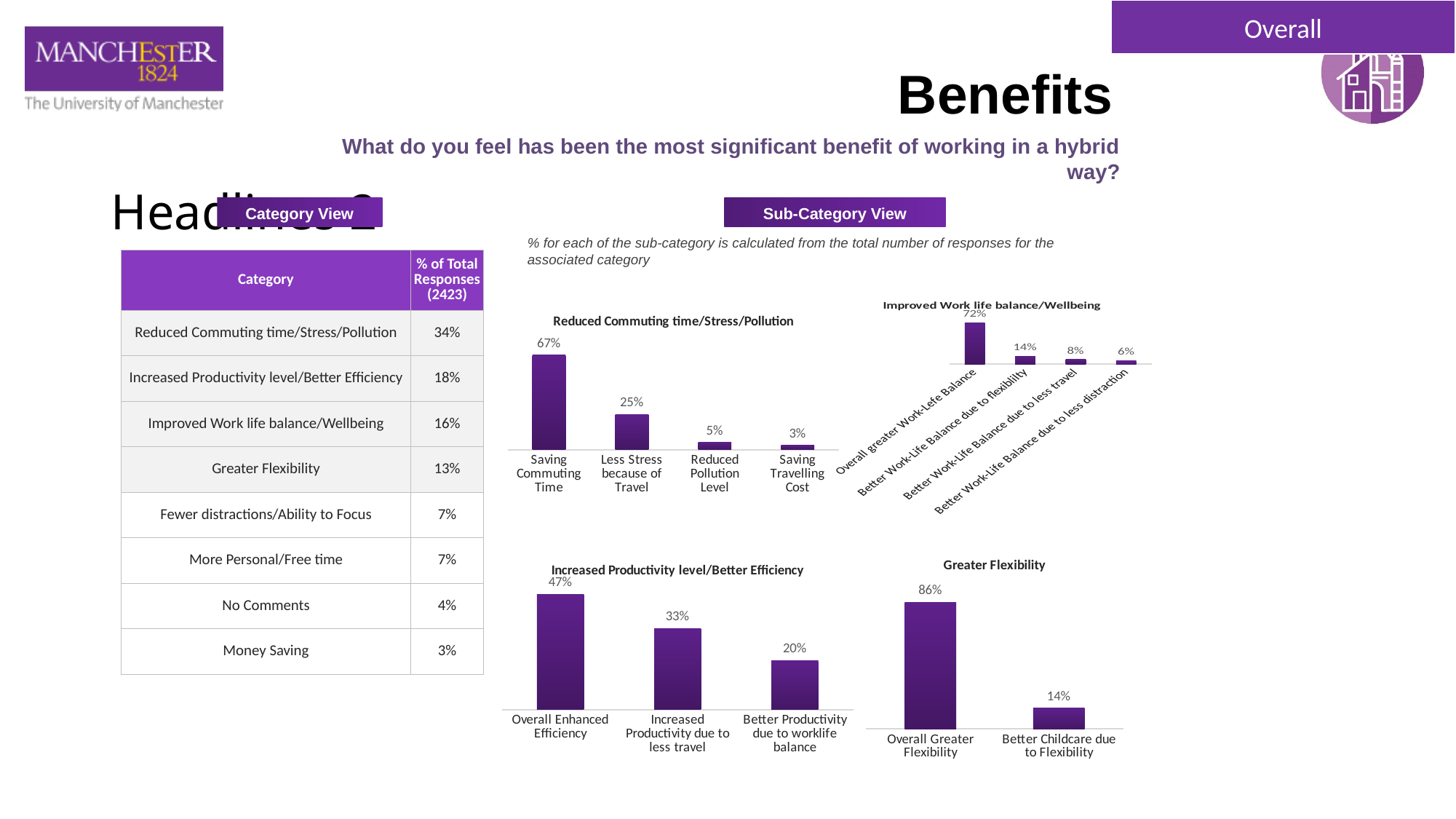
In the 'Reduced Commuting time/Stress/Pollution' chart, what is the difference between Saving Commuting Time and Less Stress because of Travel? 42% In the 'Reduced Commuting time/Stress/Pollution' chart, which category has the lowest value? Saving Travelling Cost In the 'Increased Productivity level/Better Efficiency' chart, do the values rise or fall from left to right? fall In the 'Greater Flexibility' chart, what is the difference between Overall Greater Flexibility and Better Childcare due to Flexibility? 72% In the 'Increased Productivity level/Better Efficiency' chart, what is the value for Increased Productivity due to less travel? 33% In the 'Reduced Commuting time/Stress/Pollution' chart, what is the value for Saving Commuting Time? 67% In the 'Improved Work life balance/Wellbeing' chart, which category has the highest value? Overall greater Work-Life Balance What kind of chart is the 'Greater Flexibility' chart? bar chart In the 'Greater Flexibility' chart, what is the value for Better Childcare due to Flexibility? 14% In the 'Improved Work life balance/Wellbeing' chart, which is larger: Better Work-Life Balance due to less travel or Better Work-Life Balance due to less distraction? Better Work-Life Balance due to less travel How many categories are shown in the 'Reduced Commuting time/Stress/Pollution' chart? 4 In the 'Improved Work life balance/Wellbeing' chart, what is the value for Better Work-Life Balance due to flexibility? 14%